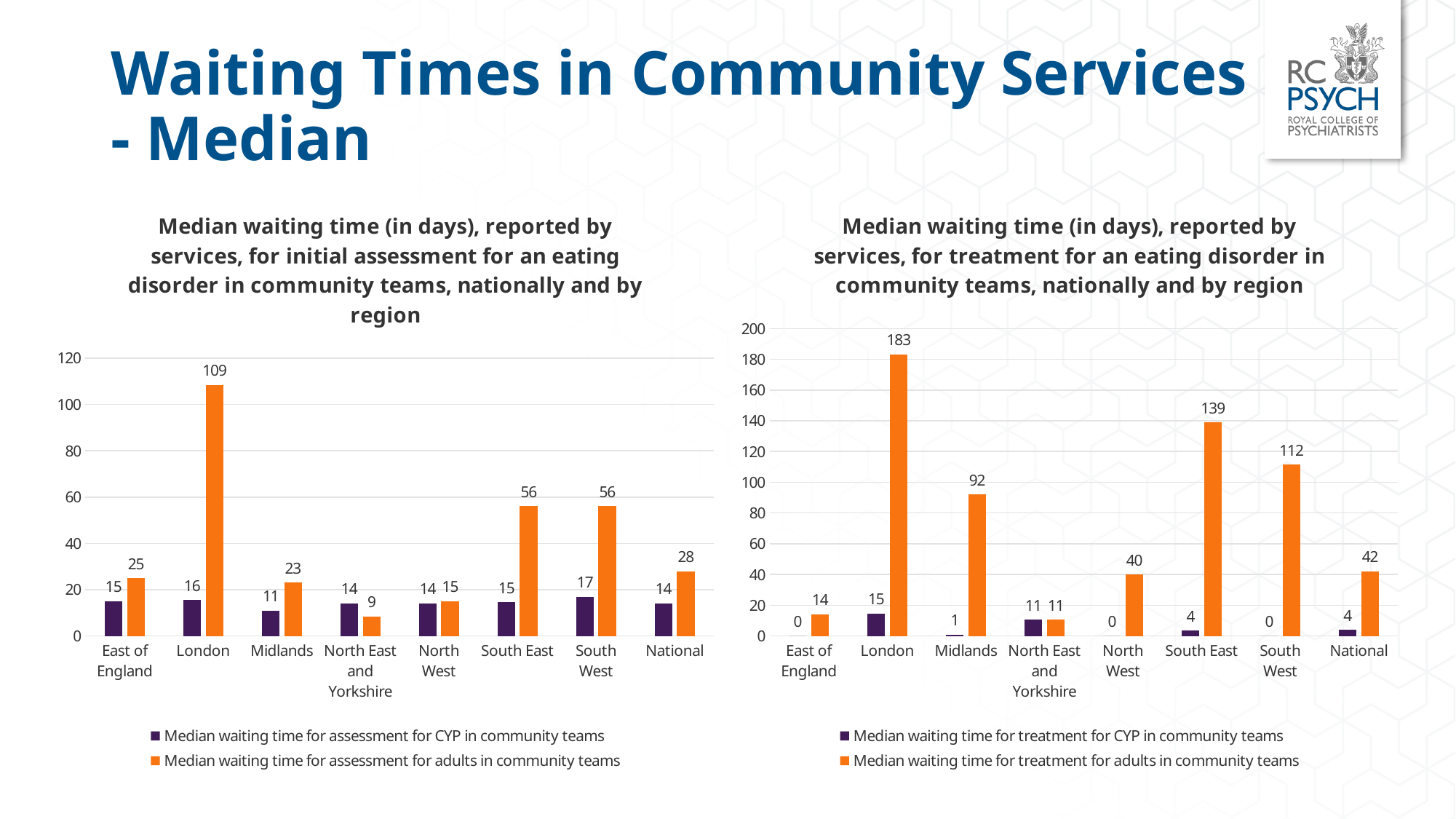
In the left chart (initial assessment), what is the difference between the adult and CYP median waiting times for assessment in London? 93 In the left chart (initial assessment), what is the median waiting time for assessment for adults in community teams in London? 109 In the left chart (initial assessment), which region has the highest median waiting time for assessment for adults? London What type of chart is used on the right side of the slide? Bar chart In the left chart (initial assessment), which region has the lowest median waiting time for assessment for adults? North East and Yorkshire In the right chart (treatment), what is the difference between the adult and CYP median waiting times for treatment in the Midlands? 91 In the right chart (treatment), is the median waiting time for treatment for adults in the Midlands greater or less than the value for the South West? less In the left chart (initial assessment), how many series does the legend list? 2 In the left chart (initial assessment), what is the median waiting time for assessment for CYP in community teams in the South West? 17 In the right chart (treatment), which region has the highest median waiting time for treatment for adults? London In the right chart (treatment), what is the median waiting time for treatment for adults in community teams in the South East? 139 In the right chart (treatment), what is the median waiting time for treatment for CYP in community teams nationally? 4